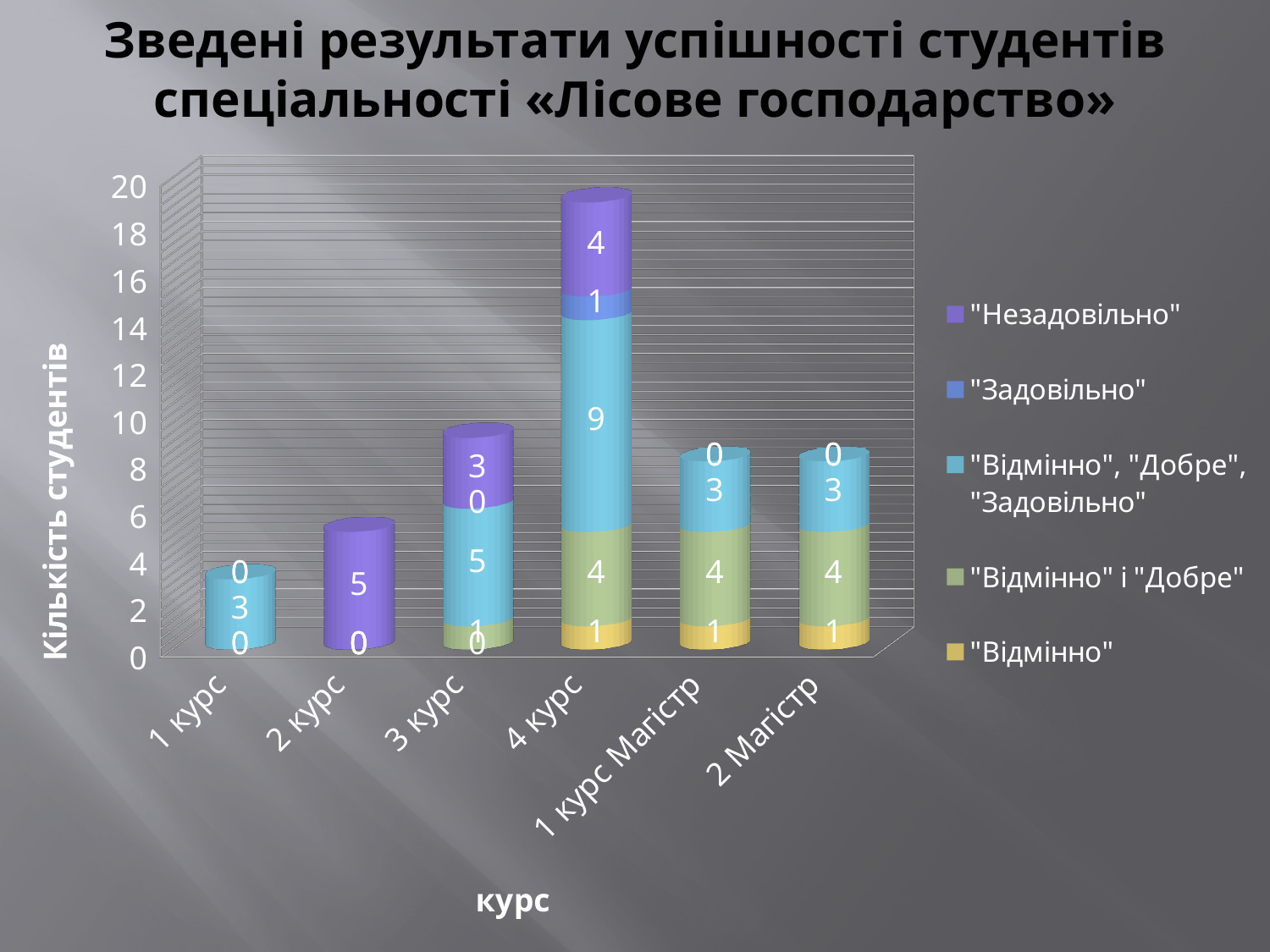
What is the difference between the "Незадовільно" values for 2 курс and 3 курс? 2 What is the total number of students in the stacked bar for 3 курс? 9 What is the value of "Відмінно", "Добре", "Задовільно" for 4 курс? 9 How many series does the legend list? 5 What kind of chart is shown on the slide? Stacked bar chart What is the value of "Незадовільно" for 2 курс? 5 What is the total number of students in the stacked bar for 4 курс? 19 What is the value of "Відмінно" і "Добре" for 1 курс Магістр? 4 How many courses (categories) are shown on the x axis? 6 What is the value of "Незадовільно" for 4 курс? 4 What is the title of the vertical axis? Кількість студентів Which course has the tallest stacked bar? 4 курс